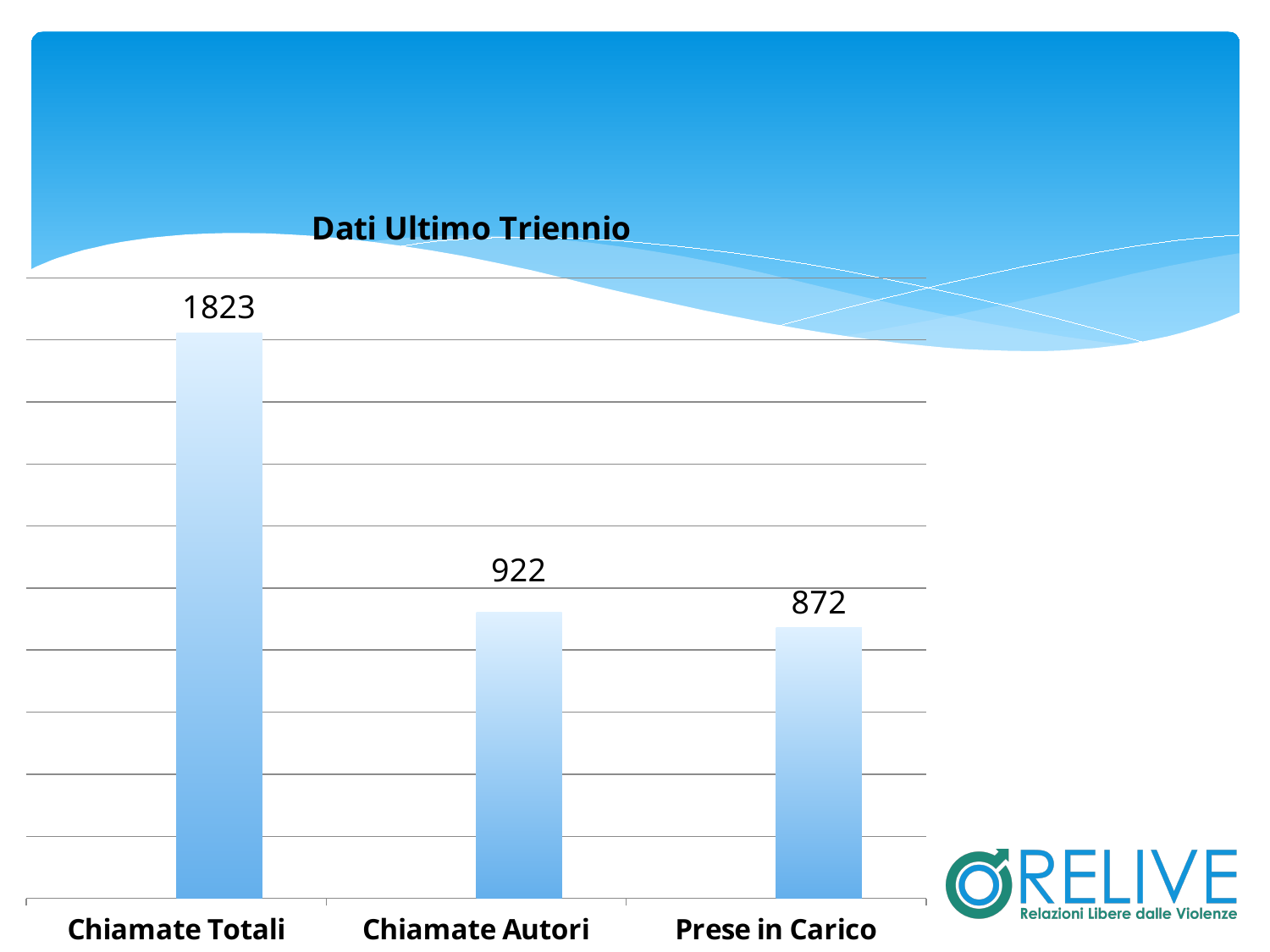
Which category has the lowest value? Prese in Carico What is the value for Prese in Carico? 872 How many categories are shown in the chart? 3 What is the title of the chart? Dati Ultimo Triennio What is the value for Chiamate Totali? 1823 Which is larger, Chiamate Totali or Prese in Carico? Chiamate Totali Which category has the highest value? Chiamate Totali Do the values rise or fall from left to right across the categories? Fall What is the difference between Chiamate Totali and Chiamate Autori? 901 What is the difference between Chiamate Autori and Prese in Carico? 50 What kind of chart is shown on the slide? Bar chart What is the value for Chiamate Autori? 922